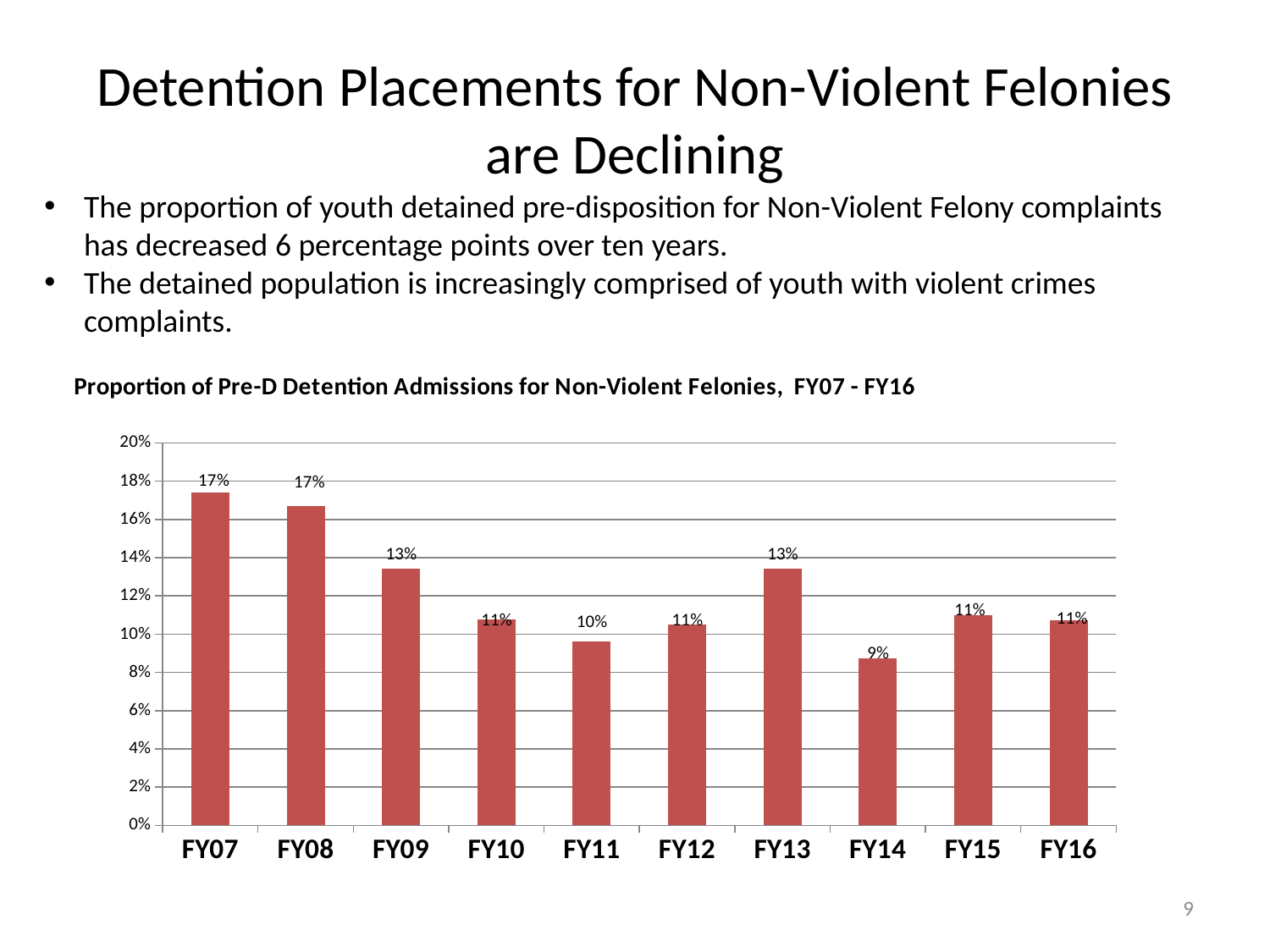
Is the value for FY13 greater or less than 12%? greater What is the title of the chart? Proportion of Pre-D Detention Admissions for Non-Violent Felonies, FY07 - FY16 What is the value for FY11? 10% Which is larger, the value for FY09 or the value for FY11? FY09 Do the values generally rise or fall from FY07 to FY16? Fall How many fiscal years are shown on the x axis? 10 What is the value for FY14? 9% What is the value for FY09? 13% What kind of chart is shown on the slide? Bar chart Which fiscal year has the lowest value? FY14 What is the value for FY16? 11% What is the difference between the values for FY07 and FY14? 8 percentage points